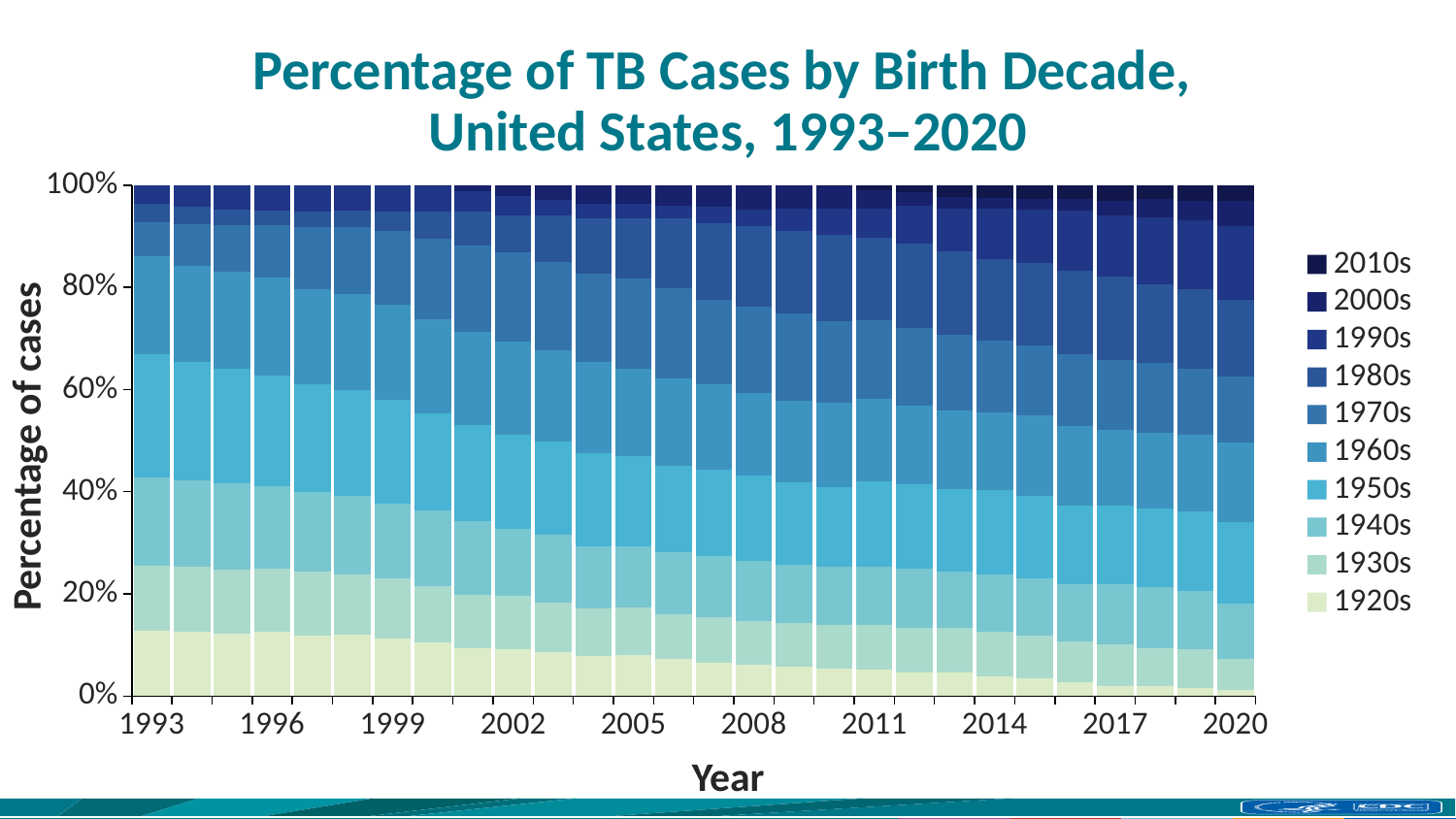
What is the label of the y axis? Percentage of cases How many years (bars) are plotted along the x axis? 28 In 2020, which segment is larger: the 1920s or the 1950s birth decade? 1950s Which birth decade is listed first (at the top) in the legend? 2010s Does the share of cases for the 1980s birth decade rise or fall from 1993 to 2020? Rise What does each stacked bar total? 100% Does the share of cases for the 1920s birth decade rise or fall from 1993 to 2020? Fall What kind of chart is shown on the slide? Stacked bar chart Is the share of cases for the 1920s birth decade in 2020 greater or less than 10%? less What is the title of the chart? Percentage of TB Cases by Birth Decade, United States, 1993–2020 How many series does the legend list? 10 Is the share of cases for the 1920s birth decade in 1993 greater or less than 10%? greater